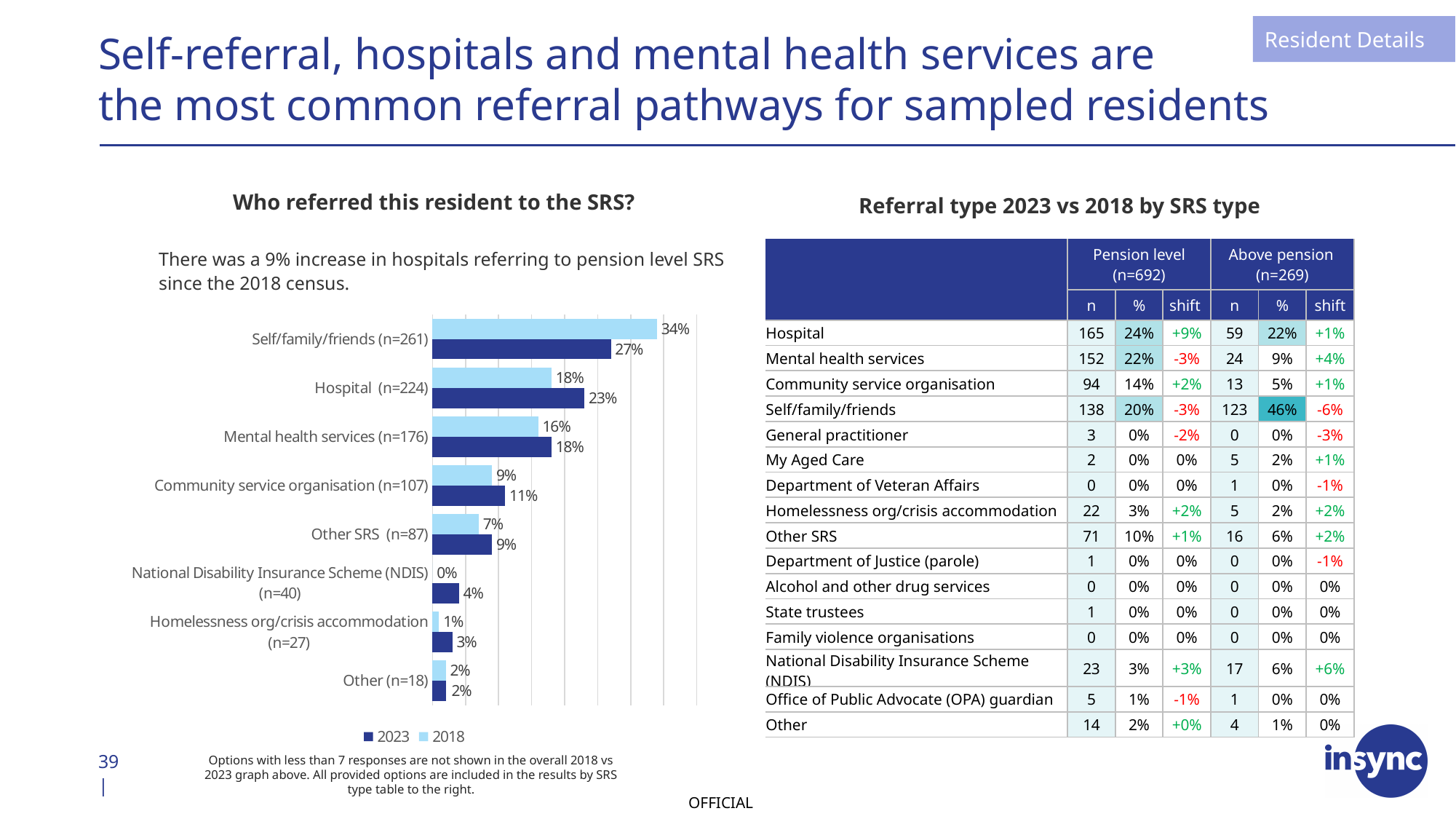
What is the 2023 value for Hospital in the 'Who referred this resident to the SRS?' chart? 23% How many categories are shown in the 'Who referred this resident to the SRS?' chart? 8 What is the 2018 value for Self/family/friends in the 'Who referred this resident to the SRS?' chart? 34% Which category has the highest 2023 value in the 'Who referred this resident to the SRS?' chart? Self/family/friends (n=261) In the 'Who referred this resident to the SRS?' chart, is the 2023 value for Hospital larger or smaller than its 2018 value? larger Which category has the lowest 2018 value in the 'Who referred this resident to the SRS?' chart? National Disability Insurance Scheme (NDIS) (n=40) What is the 2023 value for Mental health services in the 'Who referred this resident to the SRS?' chart? 18% In the 'Who referred this resident to the SRS?' chart, what is the difference between the 2018 and 2023 values for Self/family/friends? 7% How many series does the legend of the 'Who referred this resident to the SRS?' chart list? 2 What kind of chart is 'Who referred this resident to the SRS?' bar chart Which series is shown in dark blue in the 'Who referred this resident to the SRS?' chart? 2023 What is the 2018 value for National Disability Insurance Scheme (NDIS) in the 'Who referred this resident to the SRS?' chart? 0%